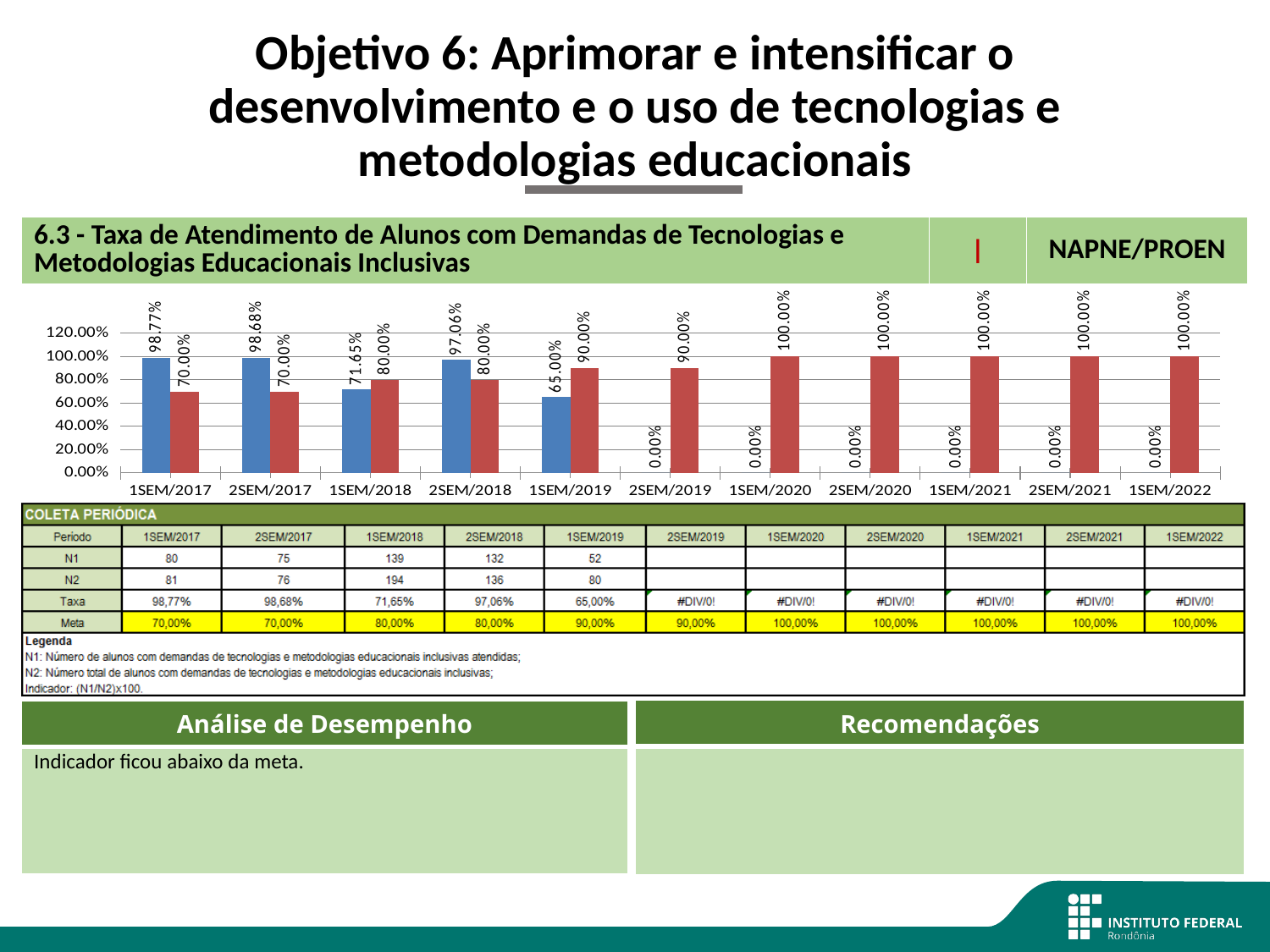
What is the value of the blue bar for 1SEM/2019? 65.00% Is the value of the blue bar for 1SEM/2019 greater or less than 80.00%? less What is the value of the blue bar for 1SEM/2017? 98.77% Which period has the highest blue bar? 1SEM/2017 What is the difference between the blue bar and the red bar for 1SEM/2018? 8.35% What is the value of the red bar for 1SEM/2022? 100.00% What is the value of the red bar for 2SEM/2018? 80.00% How many periods (categories) are shown on the x axis of the chart? 11 For 2SEM/2017, which is larger: the blue bar or the red bar? the blue bar Do the red bars rise or fall from 1SEM/2017 to 1SEM/2022? rise What type of chart is shown on the slide? bar chart Among the periods with a non-zero blue bar, which period has the lowest blue bar? 1SEM/2019